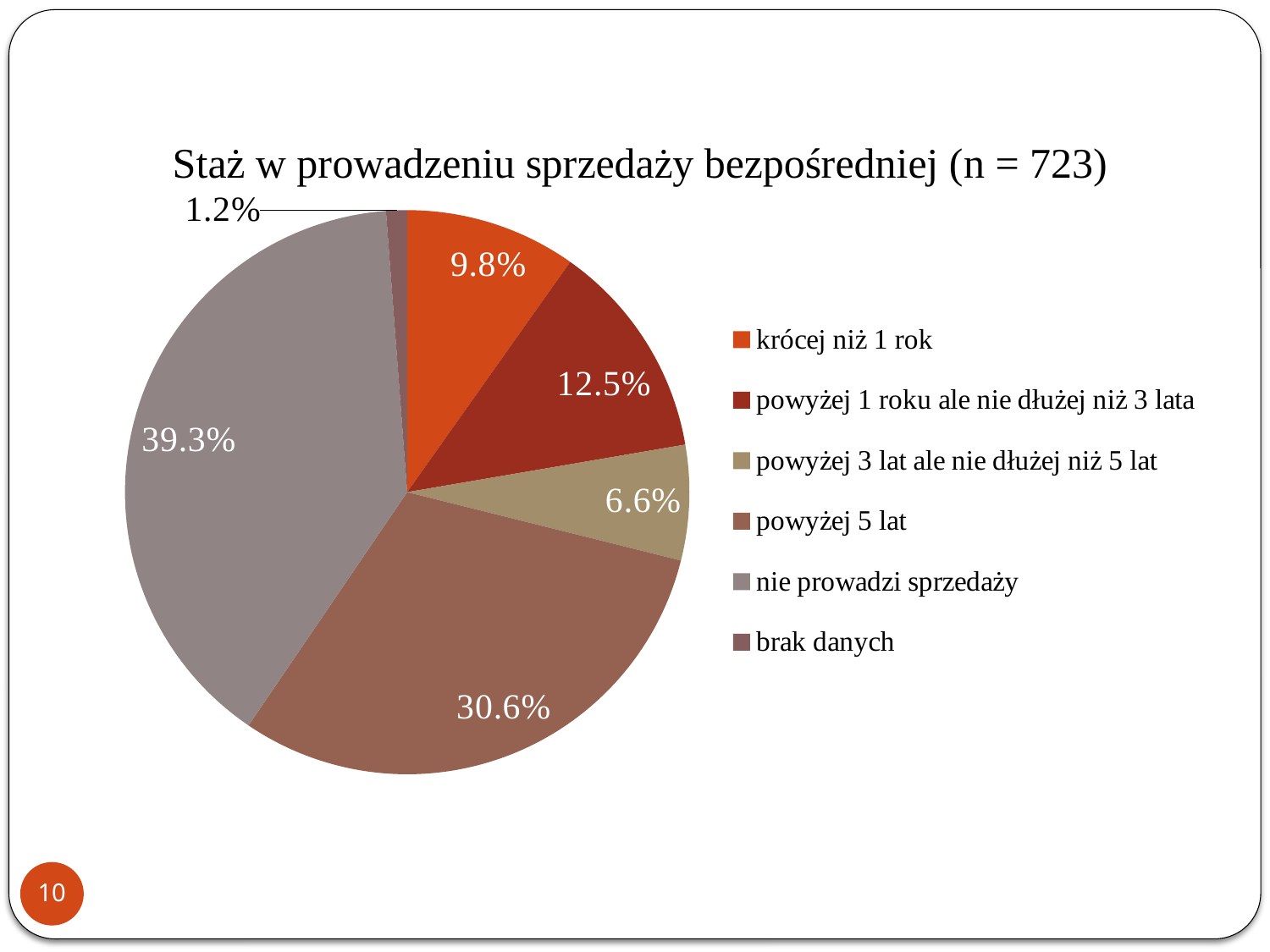
What share of the pie is labelled 'powyżej 3 lat ale nie dłużej niż 5 lat'? 6.6% What share of the pie is labelled 'powyżej 5 lat'? 30.6% Which category has the smallest slice of the pie? brak danych Which category has the largest slice of the pie? nie prowadzi sprzedaży What is the difference in percentage points between 'nie prowadzi sprzedaży' and 'powyżej 5 lat'? 8.7 What share of the pie is labelled 'brak danych'? 1.2% What type of chart is shown on the slide? pie chart What is the title of the chart? Staż w prowadzeniu sprzedaży bezpośredniej (n = 723) How many categories does the legend list? 6